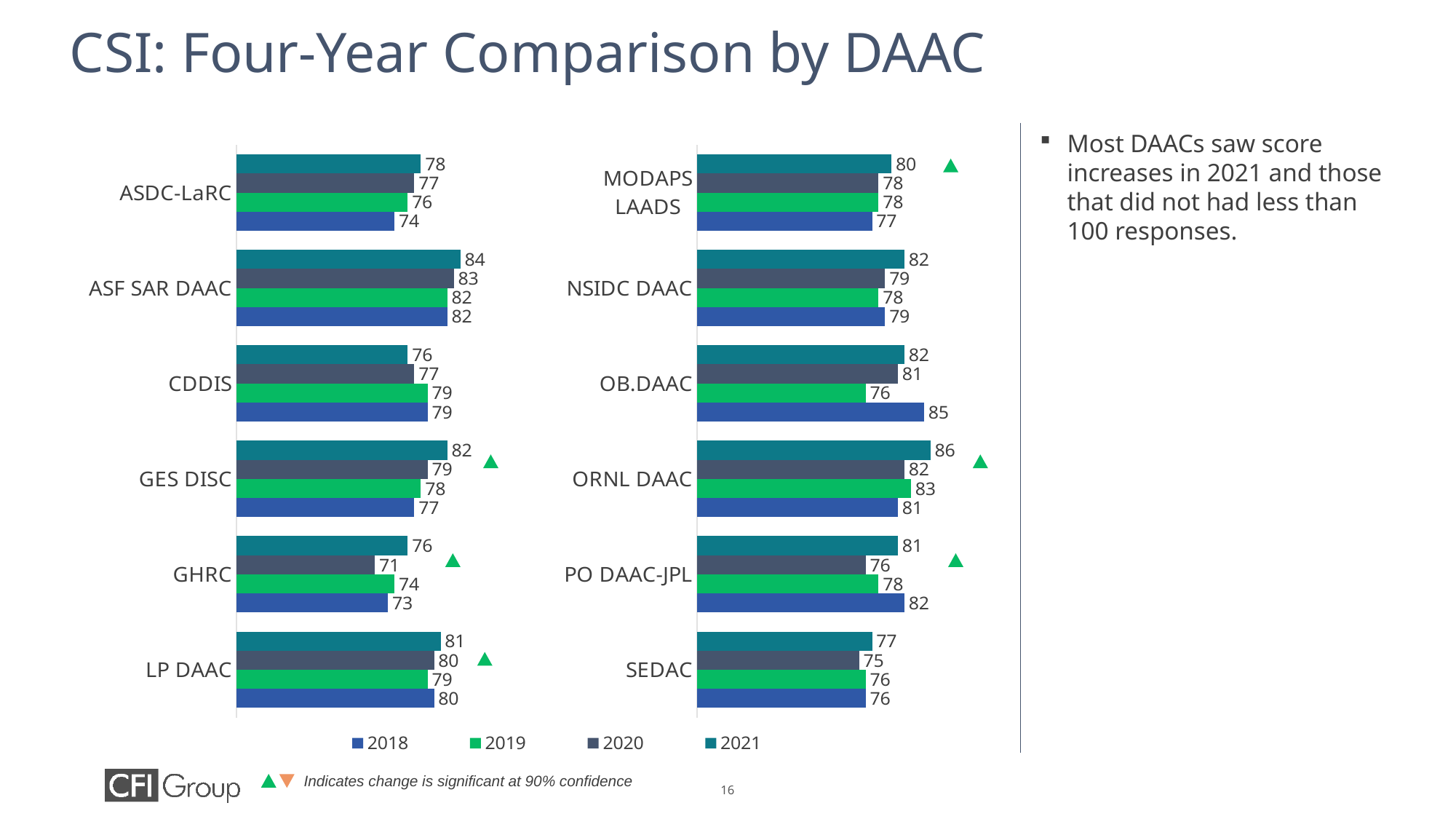
In the right chart, what is the 2018 value for OB.DAAC? 85 In the right chart, which is larger for PO DAAC-JPL, the 2018 value or the 2021 value? 2018 What kind of chart is used on this slide? Bar chart In the left chart, do the values for ASDC-LaRC rise or fall from 2018 to 2021? Rise In the right chart, which DAAC has the highest 2021 value? ORNL DAAC In the right chart, what is the difference between the 2021 and 2020 values for SEDAC? 2 In the right chart, what is the 2020 value for NSIDC DAAC? 79 In the left chart, which DAAC has the lowest 2018 value? GHRC In the left chart, what is the 2021 value for GHRC? 76 In the left chart, what is the difference between the 2021 and 2018 values for GES DISC? 5 How many series does the legend list? 4 How many DAACs are shown in the left chart? 6